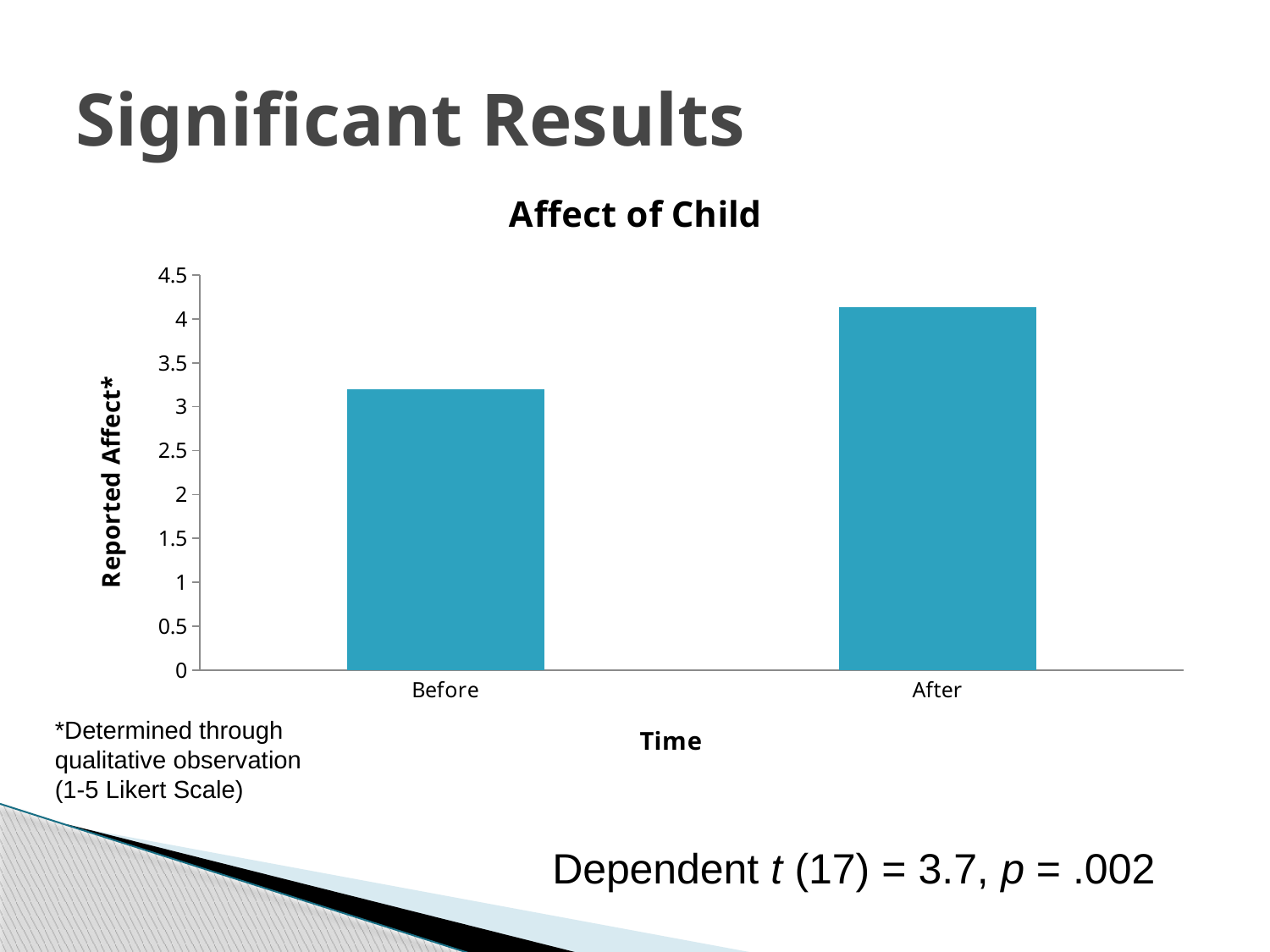
Which is larger, the value for Before or the value for After? After How many categories are shown on the x axis of the chart? 2 What type of chart is shown on the slide? bar chart Is the value for Before greater or less than 3.5? less Which category has the highest Reported Affect? After Do the values rise or fall from Before to After? rise Is the value for After greater or less than 4.5? less Is the value for Before greater or less than 3? greater What is the label of the y axis of the chart? Reported Affect* What is the title of the chart? Affect of Child Which category has the lowest Reported Affect? Before